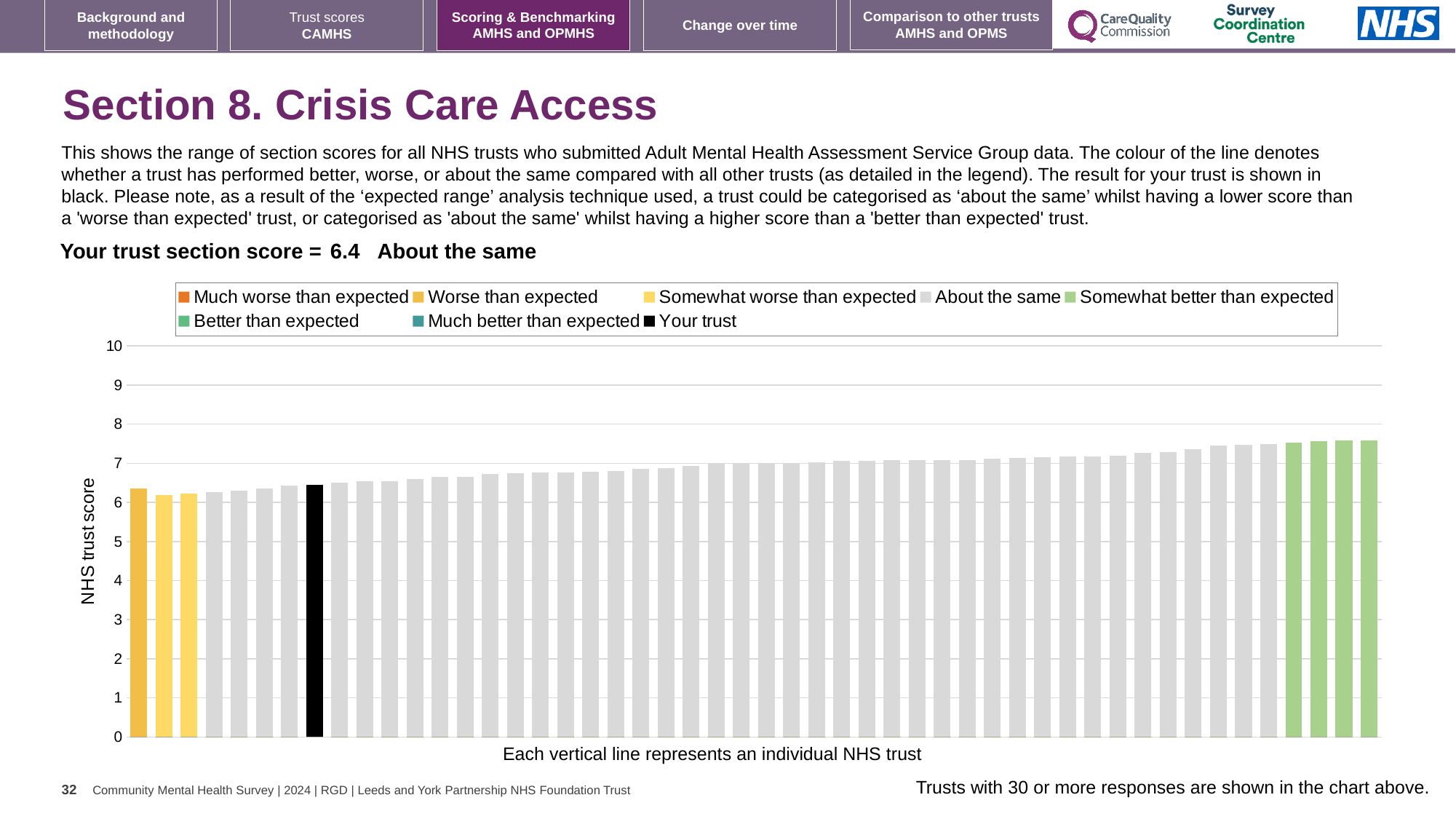
Is the tallest bar in the chart greater or less than 8? less How many entries does the chart legend list? 8 How many bars are coloured green (somewhat better than expected)? 4 Is the value of the black 'Your trust' bar greater or less than 5? greater Do the bar values rise or fall from left to right along the x axis? rise What kind of chart is shown on the slide? bar chart Is the tallest bar in the chart greater or less than 7? greater What is the section score for your trust shown on the slide? 6.4 Which category is your trust placed in for this section? About the same What is the label on the vertical axis of the chart? NHS trust score